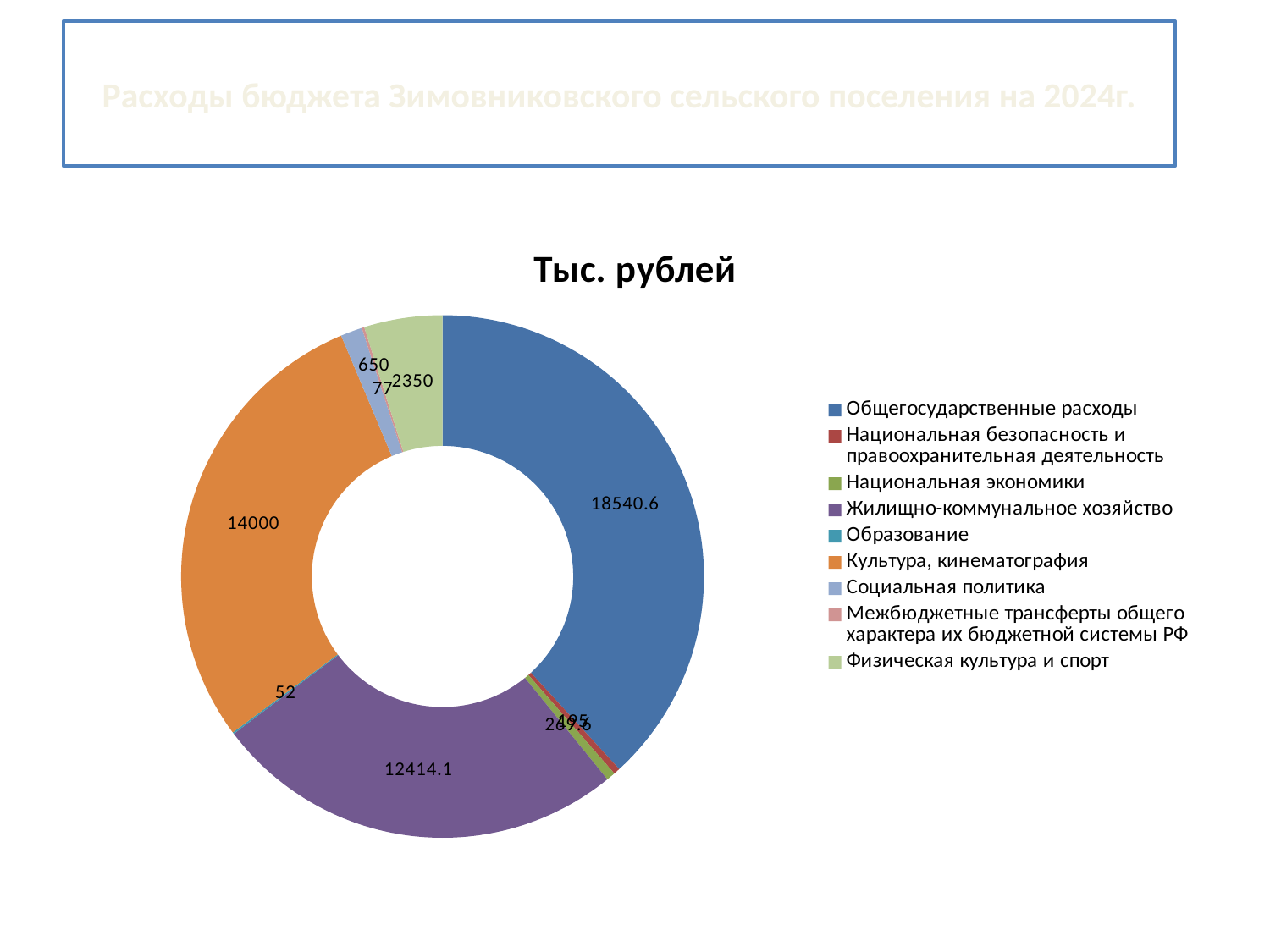
What is the value for Образование? 52 Which category has the largest value? Общегосударственные расходы What is the value for Жилищно-коммунальное хозяйство? 12414.1 How many categories does the legend list? 9 What is the value for Общегосударственные расходы? 18540.6 What is the value for Культура, кинематография? 14000 Which category has the smallest value? Образование What is the value for Физическая культура и спорт? 2350 Which is larger: Культура, кинематография or Жилищно-коммунальное хозяйство? Культура, кинематография What kind of chart is shown on the slide? doughnut chart What is the difference between Общегосударственные расходы and Культура, кинематография? 4540.6 What is the value for Социальная политика? 650